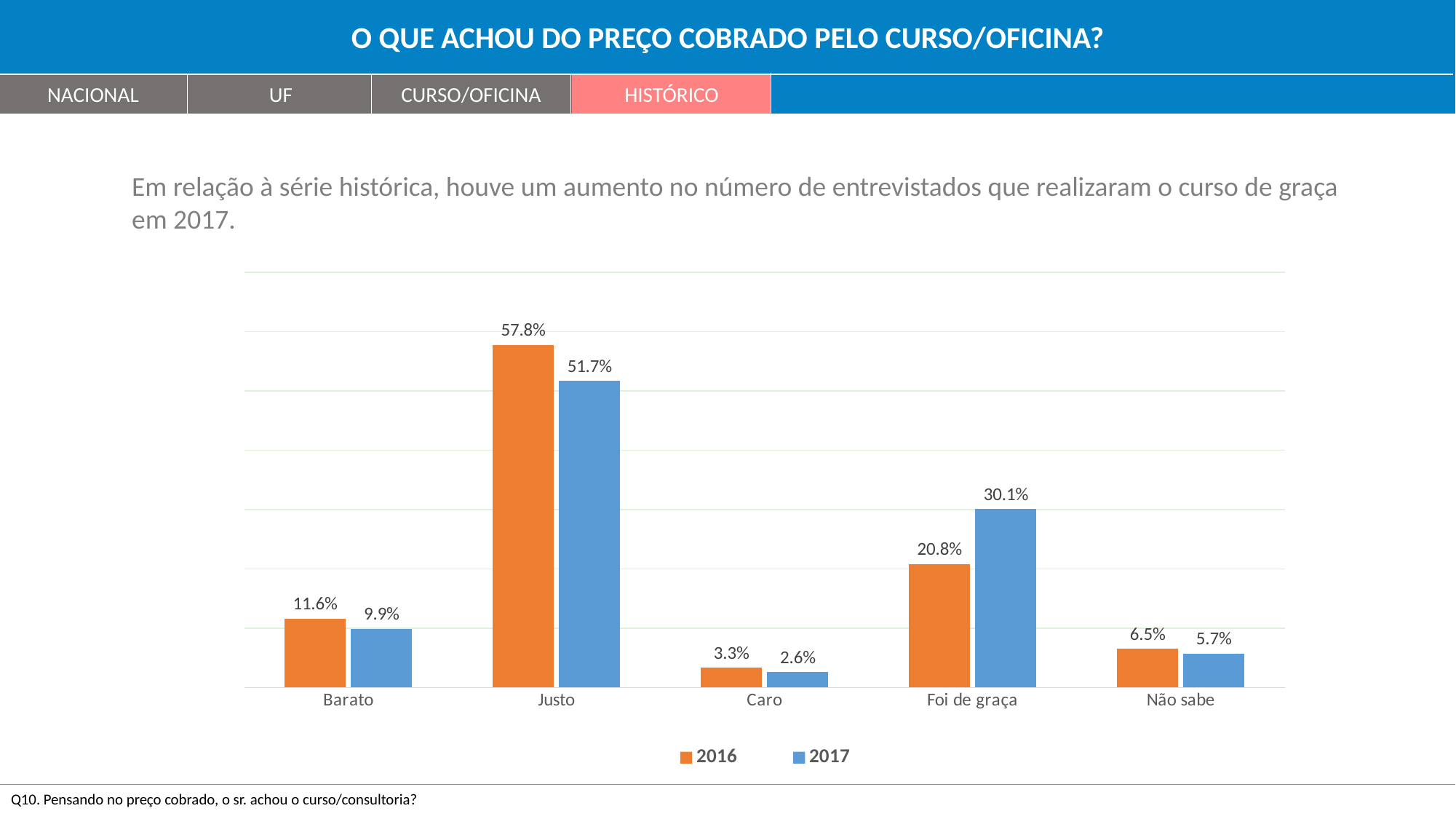
What is the value for Justo in 2016? 57.8% How many series does the legend list? 2 What is the value for Não sabe in 2016? 6.5% What is the value for Caro in 2017? 2.6% Which category has the highest value in 2017? Justo Which is larger for Barato: the 2016 value or the 2017 value? 2016 How many categories are shown on the x axis? 5 What kind of chart is shown on the slide? Bar chart Which category has the lowest value in 2016? Caro What is the difference between the 2017 and 2016 values for Foi de graça? 9.3% What is the value for Foi de graça in 2017? 30.1% What is the difference between the 2016 and 2017 values for Justo? 6.1%